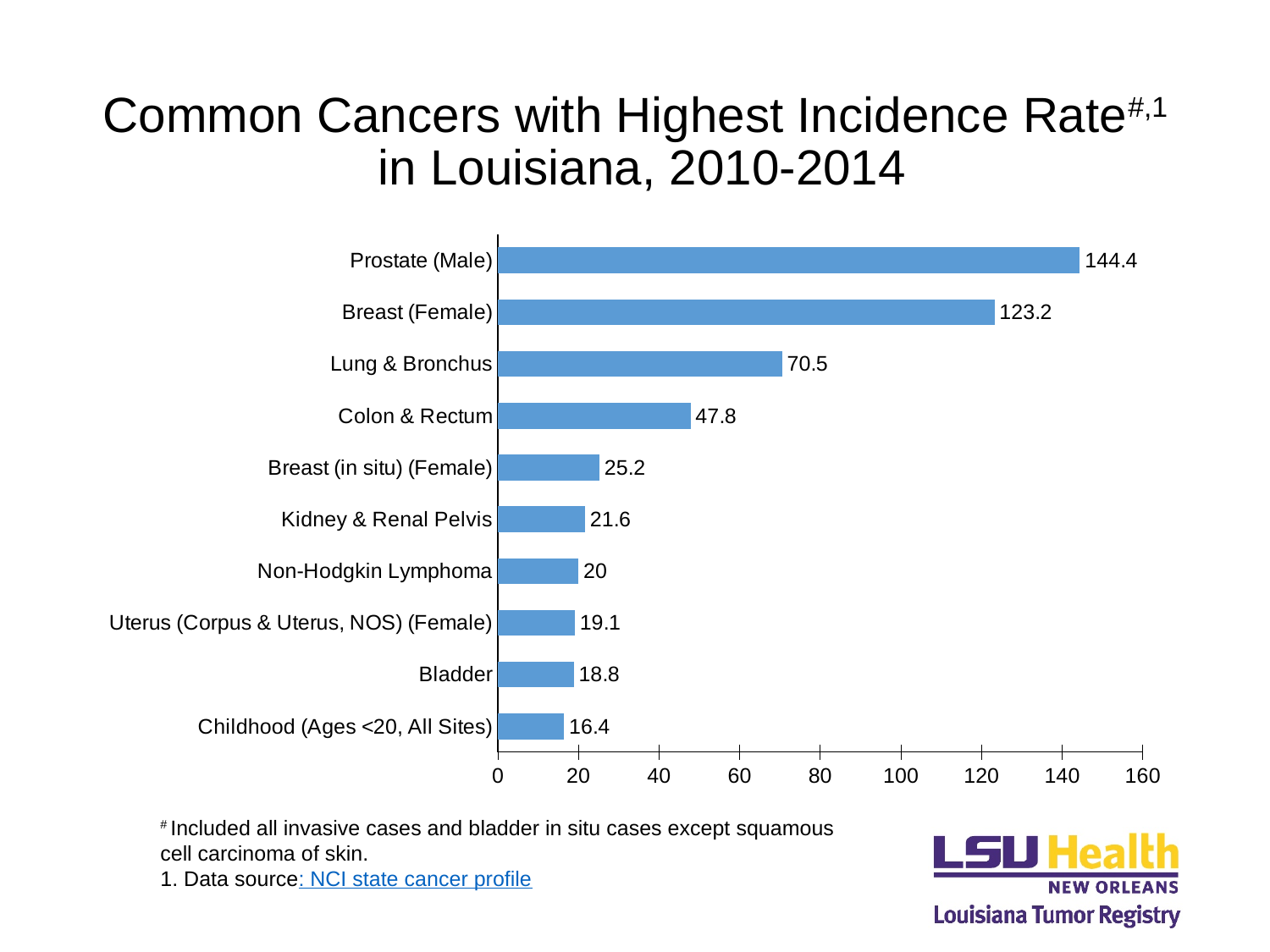
Which has a higher incidence rate, Bladder or Non-Hodgkin Lymphoma? Non-Hodgkin Lymphoma What is the difference between the incidence rates for Lung & Bronchus and Colon & Rectum? 22.7 Which category has the lowest incidence rate? Childhood (Ages <20, All Sites) What is the incidence rate for Kidney & Renal Pelvis? 21.6 What is the incidence rate for Prostate (Male)? 144.4 What kind of chart is shown on the slide? Bar chart What is the difference between the incidence rates for Prostate (Male) and Breast (Female)? 21.2 What is the incidence rate for Lung & Bronchus? 70.5 Is the value for Colon & Rectum greater or less than 40? greater What is the maximum value shown on the horizontal axis? 160 Which cancer has the highest incidence rate? Prostate (Male) How many cancer categories are shown in the chart? 10